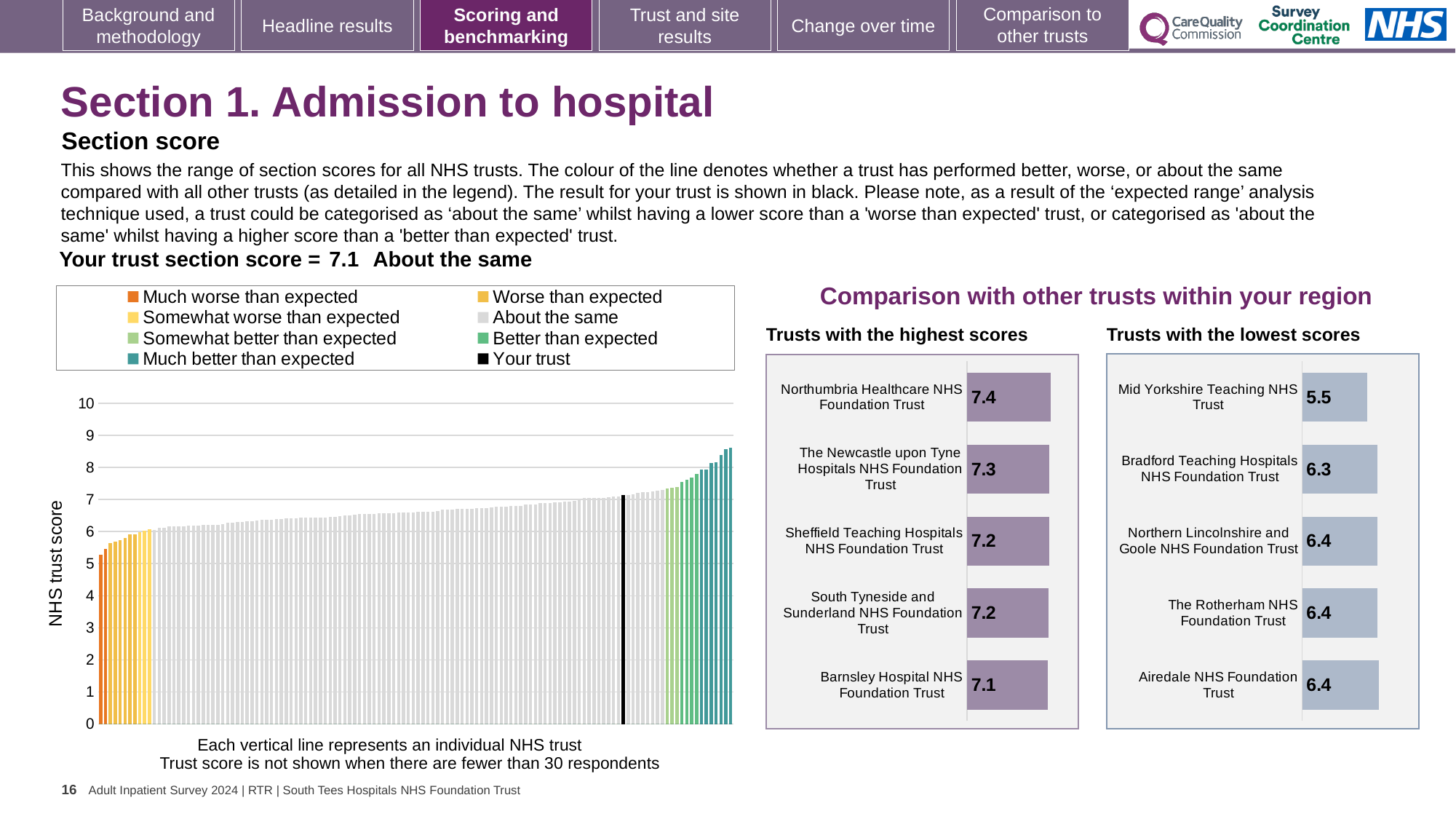
In the 'Trusts with the highest scores' chart, which has the larger score: The Newcastle upon Tyne Hospitals NHS Foundation Trust or Barnsley Hospital NHS Foundation Trust? The Newcastle upon Tyne Hospitals NHS Foundation Trust In the 'Trusts with the lowest scores' chart, which trust has the lowest score? Mid Yorkshire Teaching NHS Trust In the 'Trusts with the lowest scores' chart, what is the difference between the scores of Bradford Teaching Hospitals NHS Foundation Trust and Mid Yorkshire Teaching NHS Trust? 0.8 In the 'Trusts with the highest scores' chart, what is the difference between the scores of Northumbria Healthcare NHS Foundation Trust and Barnsley Hospital NHS Foundation Trust? 0.3 In the 'Trusts with the lowest scores' chart, what is the score for Airedale NHS Foundation Trust? 6.4 In the 'Trusts with the highest scores' chart, which trust has the highest score? Northumbria Healthcare NHS Foundation Trust What kind of chart is the large chart on the left showing NHS trust scores? Bar chart In the 'Trusts with the highest scores' chart, what is the score for Northumbria Healthcare NHS Foundation Trust? 7.4 In the 'Trusts with the lowest scores' chart, what is the score for Mid Yorkshire Teaching NHS Trust? 5.5 How many trusts are shown in the 'Trusts with the highest scores' chart? 5 How many entries does the legend of the large chart on the left list? 8 In the large chart on the left, do the NHS trust scores rise or fall from left to right? Rise